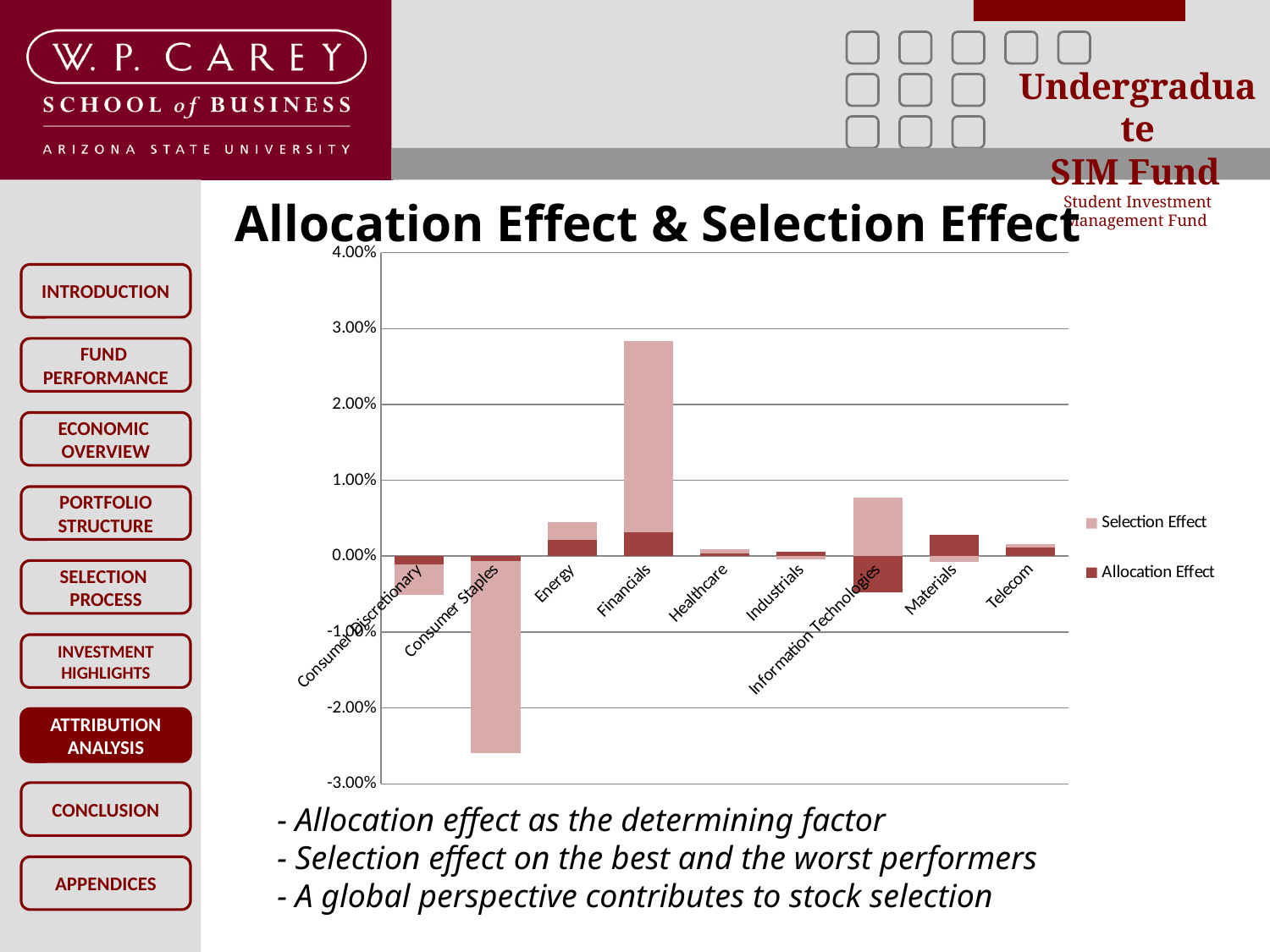
Which sector has the lowest Selection Effect in the chart? Consumer Staples Is the Selection Effect for Financials greater or less than 2.00%? greater Which sector has a larger Allocation Effect, Materials or Healthcare? Materials What kind of chart is shown on the slide? Stacked bar chart Which series is shown in the darker red colour in the chart legend? Allocation Effect Which sector has a larger Selection Effect, Financials or Information Technologies? Financials How many sector categories are plotted on the x axis of the chart? 9 What is the title of the chart on the slide? Allocation Effect & Selection Effect How many series does the chart legend list? 2 Is the Selection Effect for Consumer Staples greater or less than -2.00%? less Which sector has the highest Selection Effect in the chart? Financials Is the Selection Effect for Information Technologies greater or less than 1.00%? less